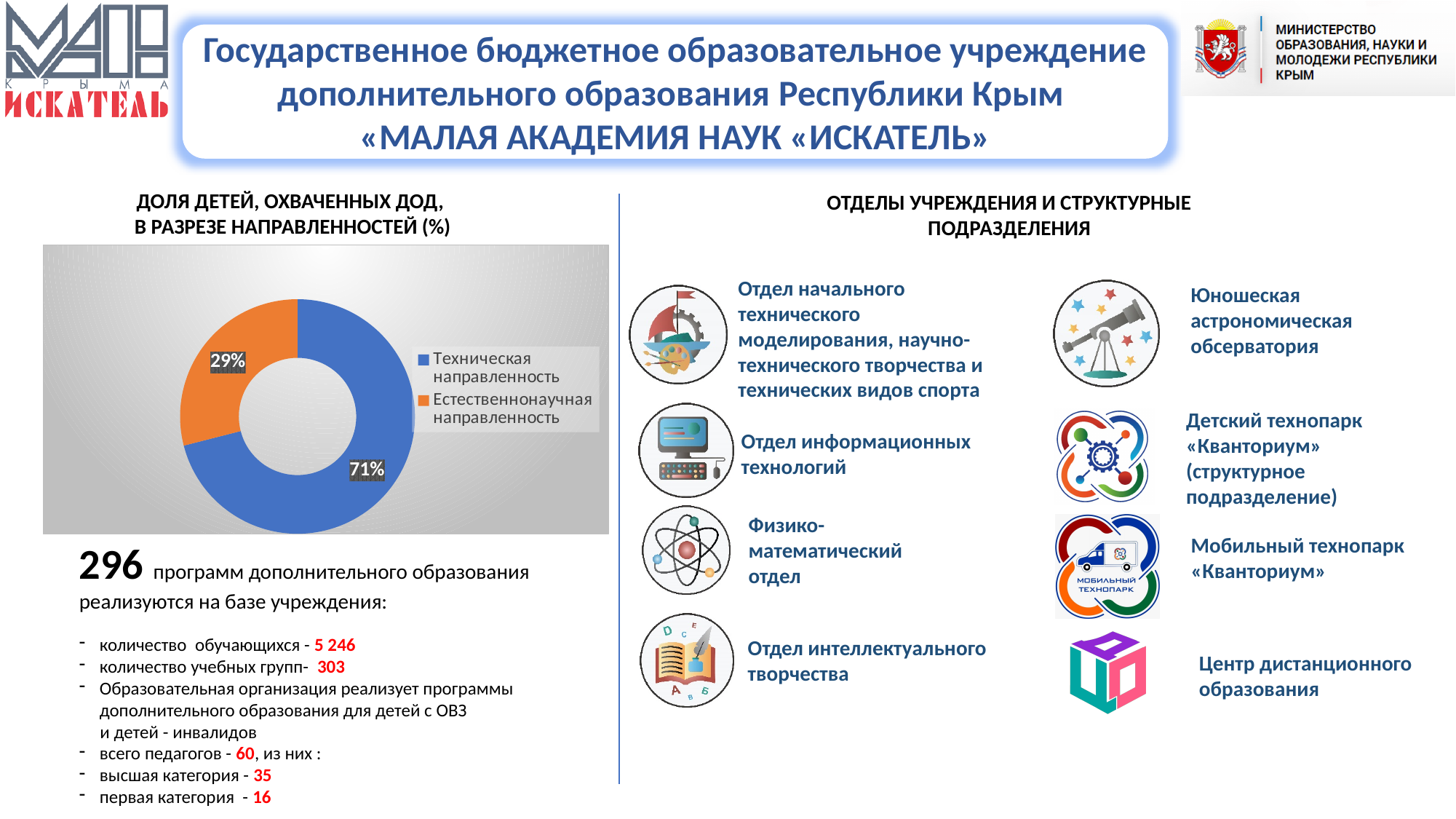
How many entries does the legend of the doughnut chart list? 2 Which is larger in the doughnut chart: "Техническая направленность" or "Естественнонаучная направленность"? Техническая направленность Which category has the smallest share in the doughnut chart? Естественнонаучная направленность What colour represents "Естественнонаучная направленность" in the doughnut chart? Orange By how many percentage points does "Техническая направленность" exceed "Естественнонаучная направленность" in the doughnut chart? 42 percentage points What is the total of the two shares shown in the doughnut chart? 100% What is the title of the doughnut chart on the left of the slide? ДОЛЯ ДЕТЕЙ, ОХВАЧЕННЫХ ДОД, В РАЗРЕЗЕ НАПРАВЛЕННОСТЕЙ (%) What share of the doughnut chart is labelled for "Техническая направленность"? 71% What type of chart is shown under the title "ДОЛЯ ДЕТЕЙ, ОХВАЧЕННЫХ ДОД, В РАЗРЕЗЕ НАПРАВЛЕННОСТЕЙ (%)"? Doughnut (pie) chart Which category has the largest share in the doughnut chart? Техническая направленность What share of the doughnut chart is labelled for "Естественнонаучная направленность"? 29% How many categories (slices) does the doughnut chart contain? 2